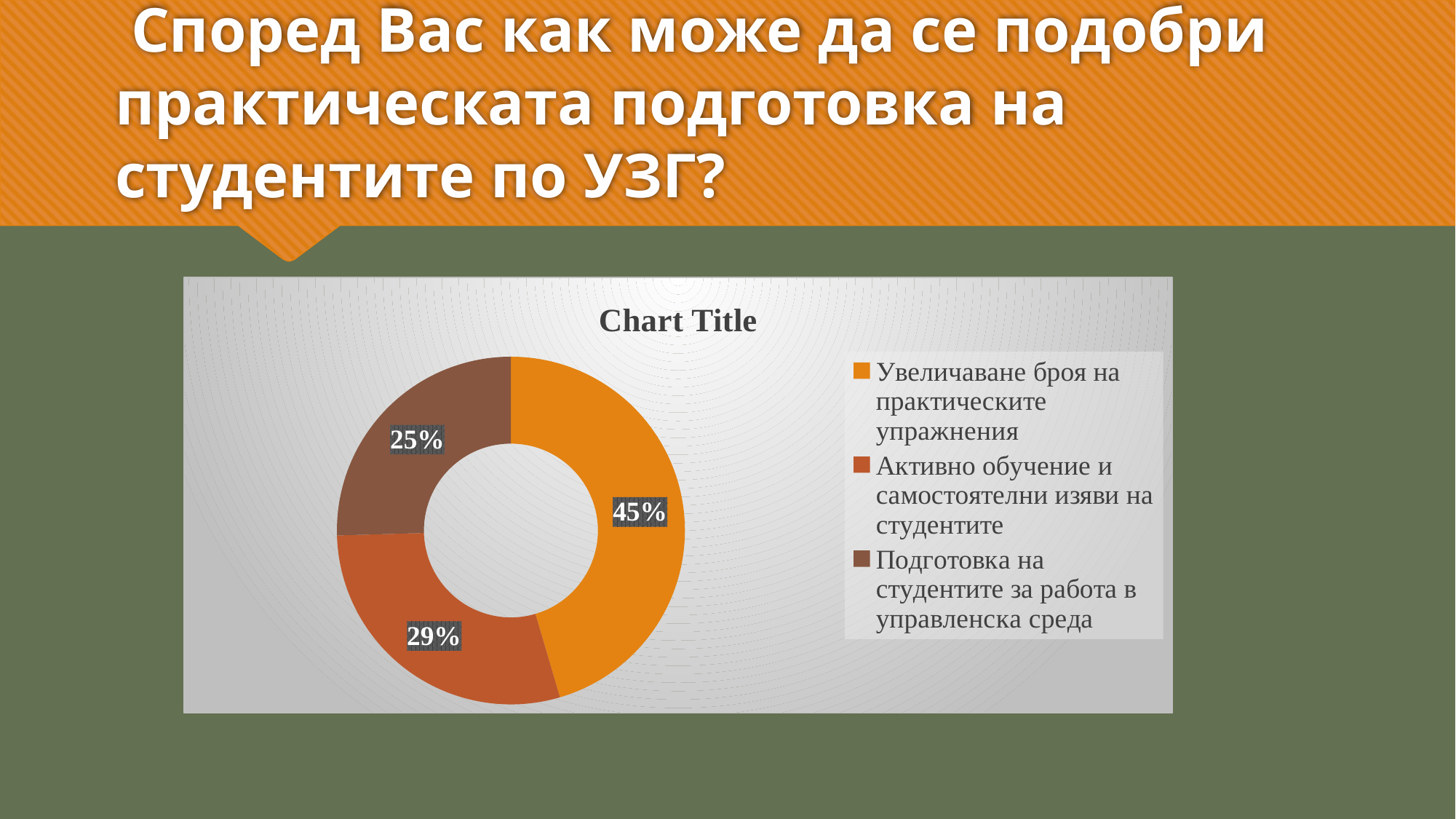
How many categories does the chart show? 3 What share of the chart does "Увеличаване броя на практическите упражнения" represent? 45% Which colour represents "Подготовка на студентите за работа в управленска среда" in the chart? Brown What is the difference in percentage points between the share for "Увеличаване броя на практическите упражнения" and the share for "Активно обучение и самостоятелни изяви на студентите"? 16 What is the title shown on the chart? Chart Title Which category has the smallest share in the chart? Подготовка на студентите за работа в управленска среда Which is larger: the share for "Активно обучение и самостоятелни изяви на студентите" or the share for "Подготовка на студентите за работа в управленска среда"? Активно обучение и самостоятелни изяви на студентите Which category has the largest share in the chart? Увеличаване броя на практическите упражнения What share of the chart does "Активно обучение и самостоятелни изяви на студентите" represent? 29% What share of the chart does "Подготовка на студентите за работа в управленска среда" represent? 25% What kind of chart is shown on the slide? Doughnut chart